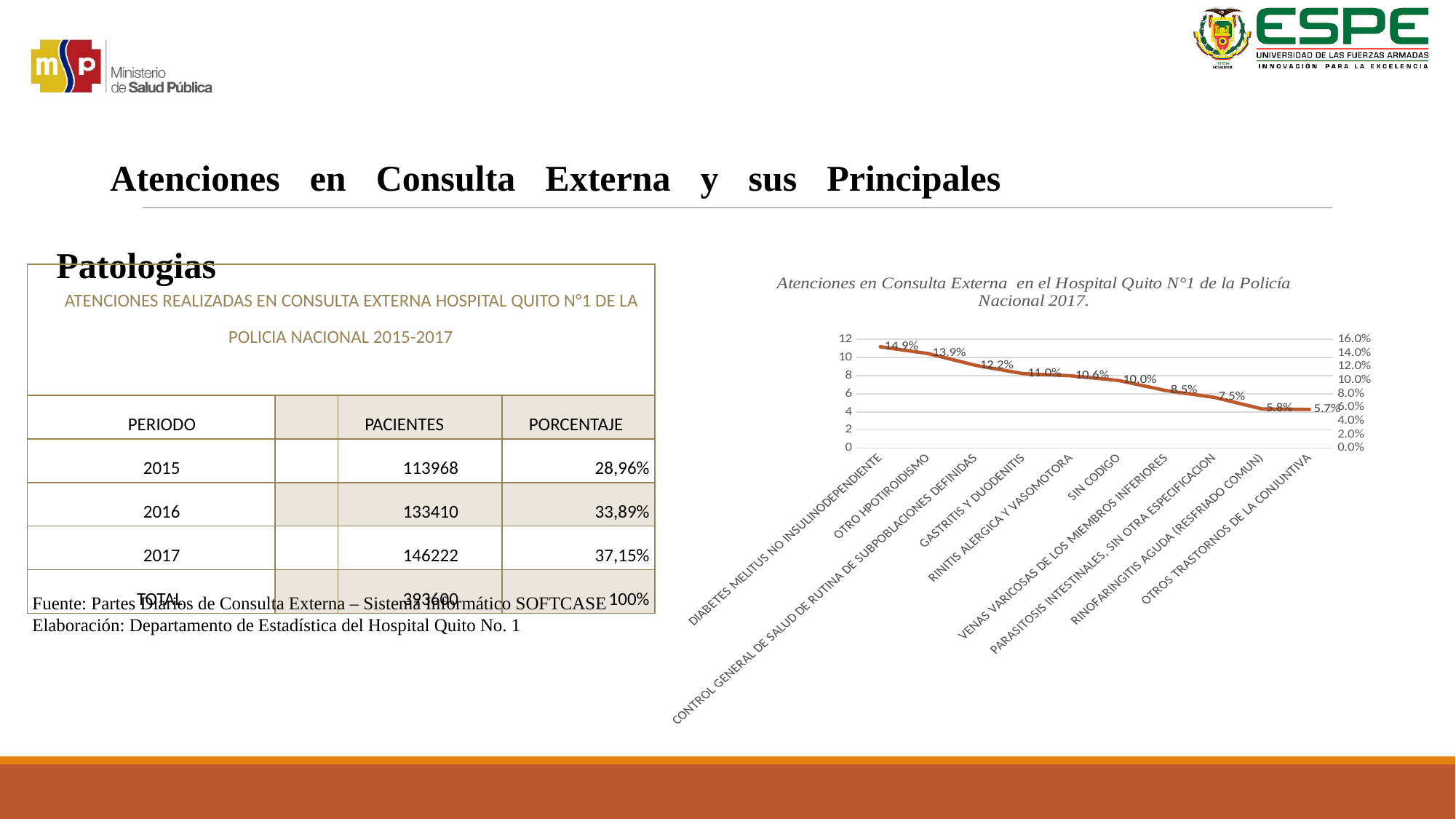
Do the values rise or fall from left to right along the x axis? fall What kind of chart is shown on the slide? line chart What is the value for GASTRITIS Y DUODENITIS? 11.0% What is the difference between the values for OTRO HPOTIROIDISMO and VENAS VARICOSAS DE LOS MIEMBROS INFERIORES? 5.4% Which is larger, the value for RINITIS ALERGICA Y VASOMOTORA or the value for PARASITOSIS INTESTINALES, SIN OTRA ESPECIFICACION? RINITIS ALERGICA Y VASOMOTORA What is the value for DIABETES MELITUS NO INSULINODEPENDIENTE? 14.9% What is the title of the chart? Atenciones en Consulta Externa en el Hospital Quito N°1 de la Policía Nacional 2017. What is the value for RINOFARINGITIS AGUDA (RESFRIADO COMUN)? 5.8% Which category has the lowest value? OTROS TRASTORNOS DE LA CONJUNTIVA Which category has the highest value? DIABETES MELITUS NO INSULINODEPENDIENTE How many categories are plotted on the chart? 10 What is the value for SIN CODIGO? 10.0%